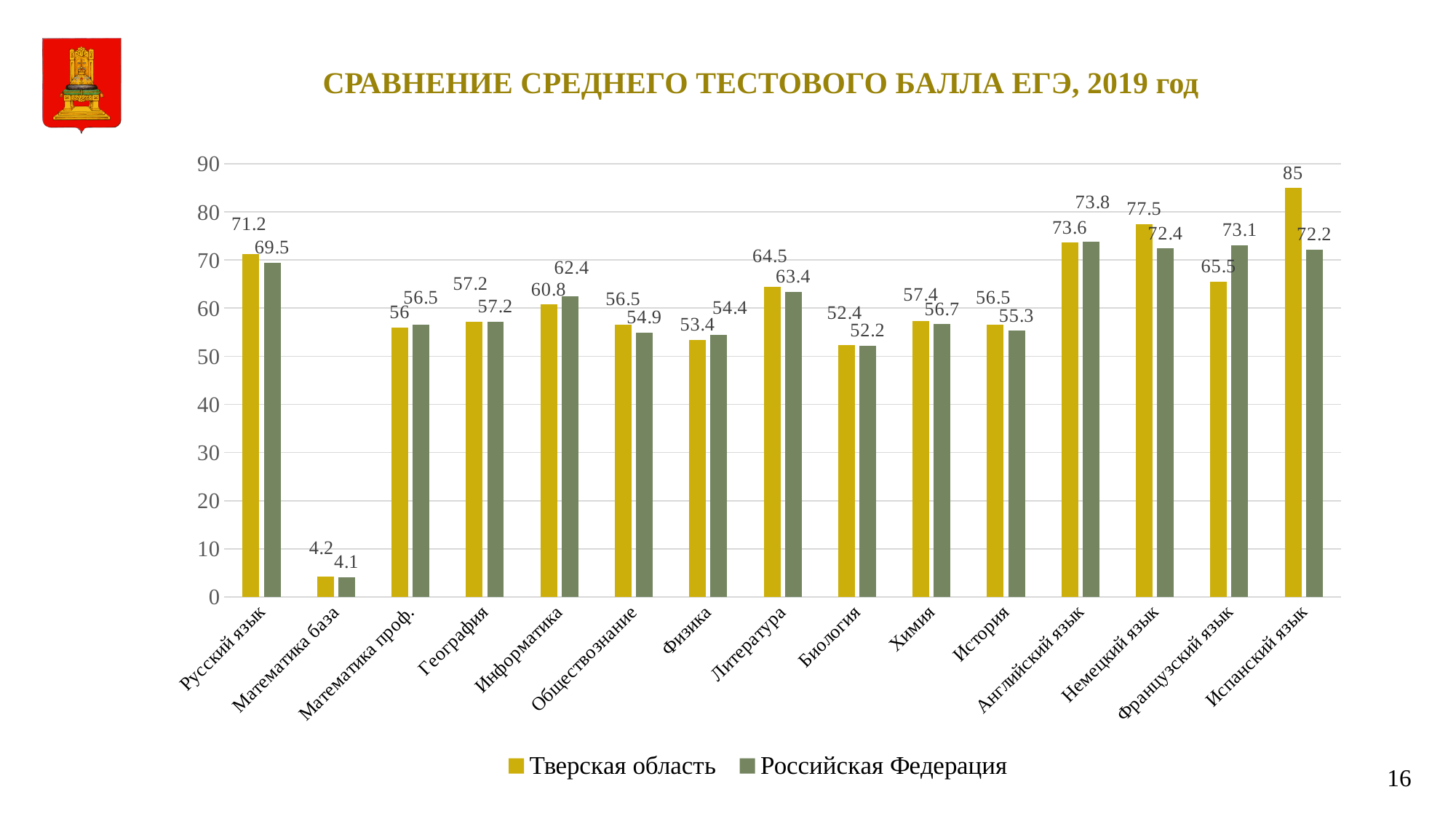
What is the value for Российская Федерация in Информатика? 62.4 What is the title of the chart? СРАВНЕНИЕ СРЕДНЕГО ТЕСТОВОГО БАЛЛА ЕГЭ, 2019 год What is the difference between Тверская область and Российская Федерация in Испанский язык? 12.8 How many subjects are shown on the x axis? 15 How many series does the legend list? 2 What is the value for Тверская область in Немецкий язык? 77.5 Which subject has the lowest value for Российская Федерация? Математика база Which subject has the highest value for Тверская область? Испанский язык What kind of chart is shown on the slide? bar chart What is the value for Тверская область in Русский язык? 71.2 Which is larger in Французский язык: Тверская область or Российская Федерация? Российская Федерация Is the value for Тверская область in Литература greater or less than 60? greater